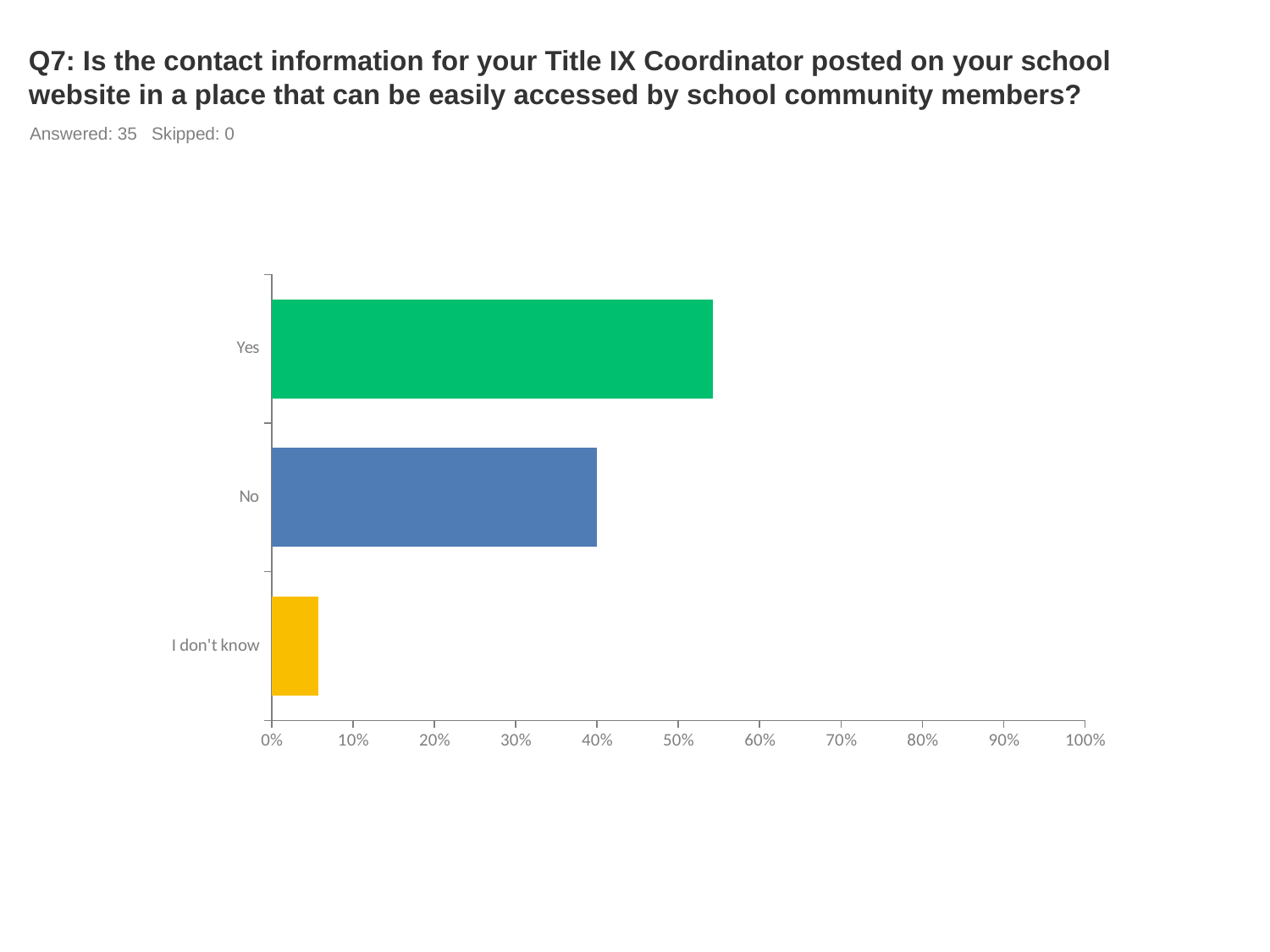
Which response category has the lowest value? I don't know Which is larger, the value for Yes or the value for No? Yes How many respondents answered this question according to the slide? 35 What colour is the bar for Yes? green Is the value for No greater or less than 50%? less Is the value for I don't know greater or less than 10%? less What kind of chart is shown on the slide? bar chart Which response category has the highest value? Yes How many response categories are shown in the chart? 3 Is the value for Yes greater or less than 50%? greater What value does the No bar reach on the axis? 40% Which is larger, the value for No or the value for I don't know? No